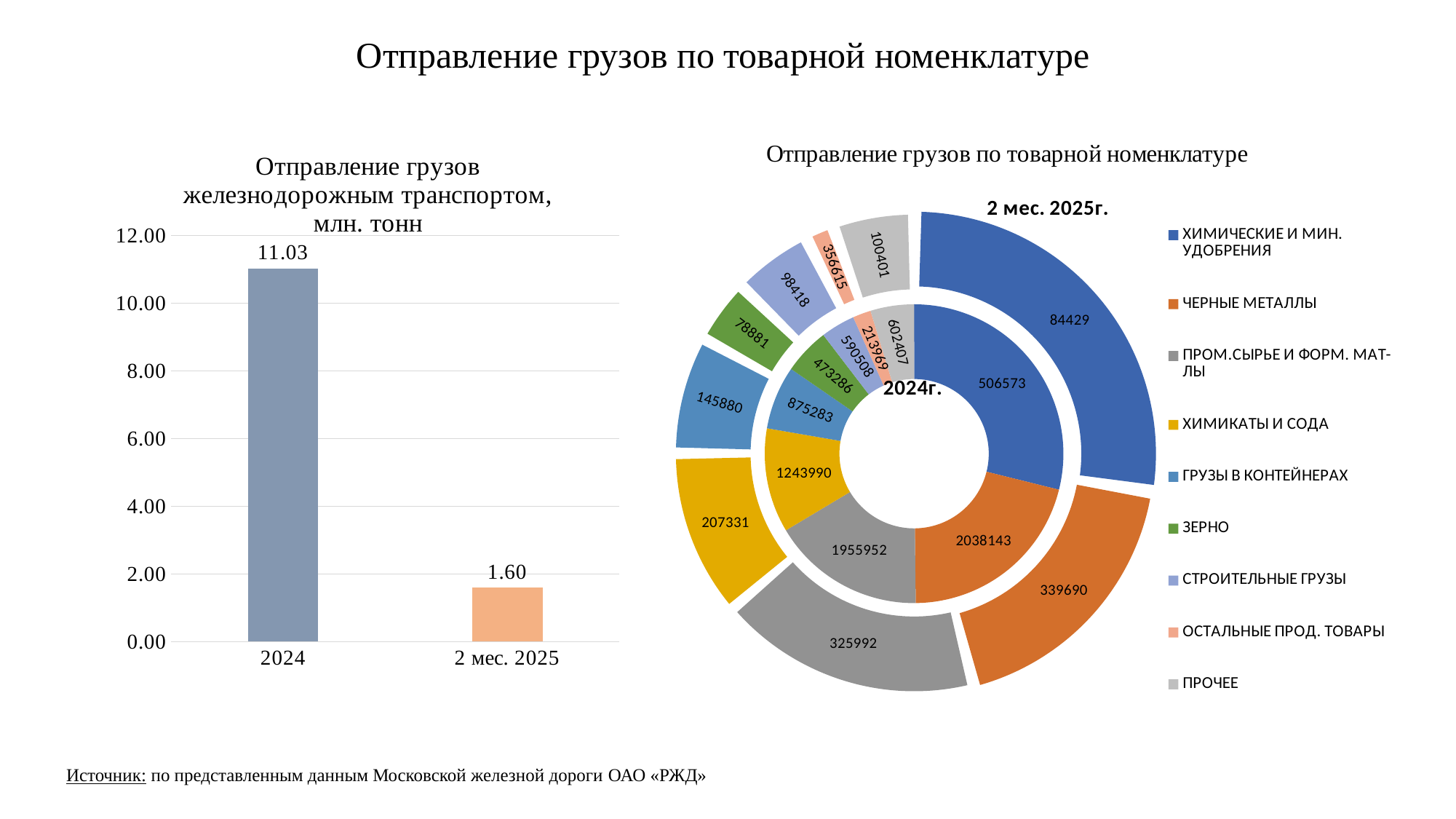
In the bar chart on the left, how many categories are shown on the x axis? 2 In the bar chart on the left, what is the value for 2 мес. 2025? 1.60 What kind of chart is the chart on the right of the slide? doughnut chart In the doughnut chart on the right, which is larger for 2 мес. 2025г.: ЧЕРНЫЕ МЕТАЛЛЫ or ПРОМ.СЫРЬЕ И ФОРМ. МАТ-ЛЫ? ЧЕРНЫЕ МЕТАЛЛЫ In the doughnut chart on the right, how many categories does the legend list? 9 In the bar chart on the left, what is the value for 2024? 11.03 In the doughnut chart on the right, what is the 2024г. value for ЧЕРНЫЕ МЕТАЛЛЫ? 2038143 What kind of chart is the chart on the left of the slide? bar chart In the doughnut chart on the right, what is the 2024г. value for ЗЕРНО? 473286 In the bar chart on the left, what is the difference between the 2024 value and the 2 мес. 2025 value? 9.43 In the doughnut chart on the right, what is the difference between the 2 мес. 2025г. values for ЧЕРНЫЕ МЕТАЛЛЫ and ПРОМ.СЫРЬЕ И ФОРМ. МАТ-ЛЫ? 13698 In the doughnut chart on the right, what is the 2 мес. 2025г. value for ХИМИКАТЫ И СОДА? 207331